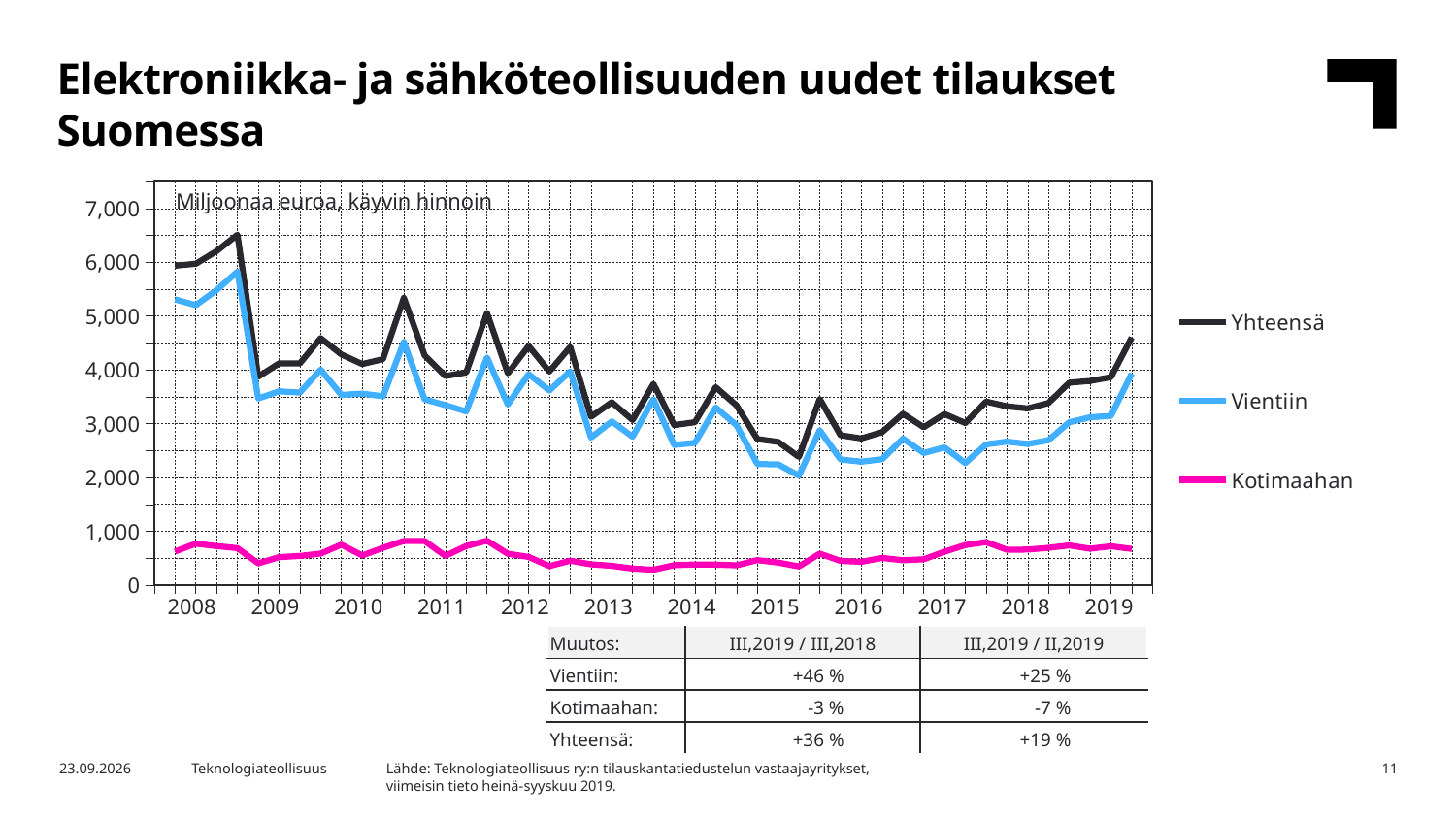
Which series has the lowest values throughout the chart? Kotimaahan Is the value for Kotimaahan in 2019 greater or less than 1,000? less What kind of chart is shown on the slide? line chart How many series does the legend list? 3 Which series has the highest values throughout the chart? Yhteensä What unit is stated at the top of the chart area? Miljoonaa euroa, käyvin hinnoin Does the Yhteensä series overall rise or fall from 2008 to 2016? fall Is the value for Yhteensä at the start of 2008 greater or less than 5,000? greater What are the three series named in the legend? Yhteensä, Vientiin, Kotimaahan Is the value for Yhteensä in 2016 greater or less than 4,000? less How many year labels are shown on the x axis? 12 Which is larger in 2018, the value for Vientiin or the value for Kotimaahan? Vientiin